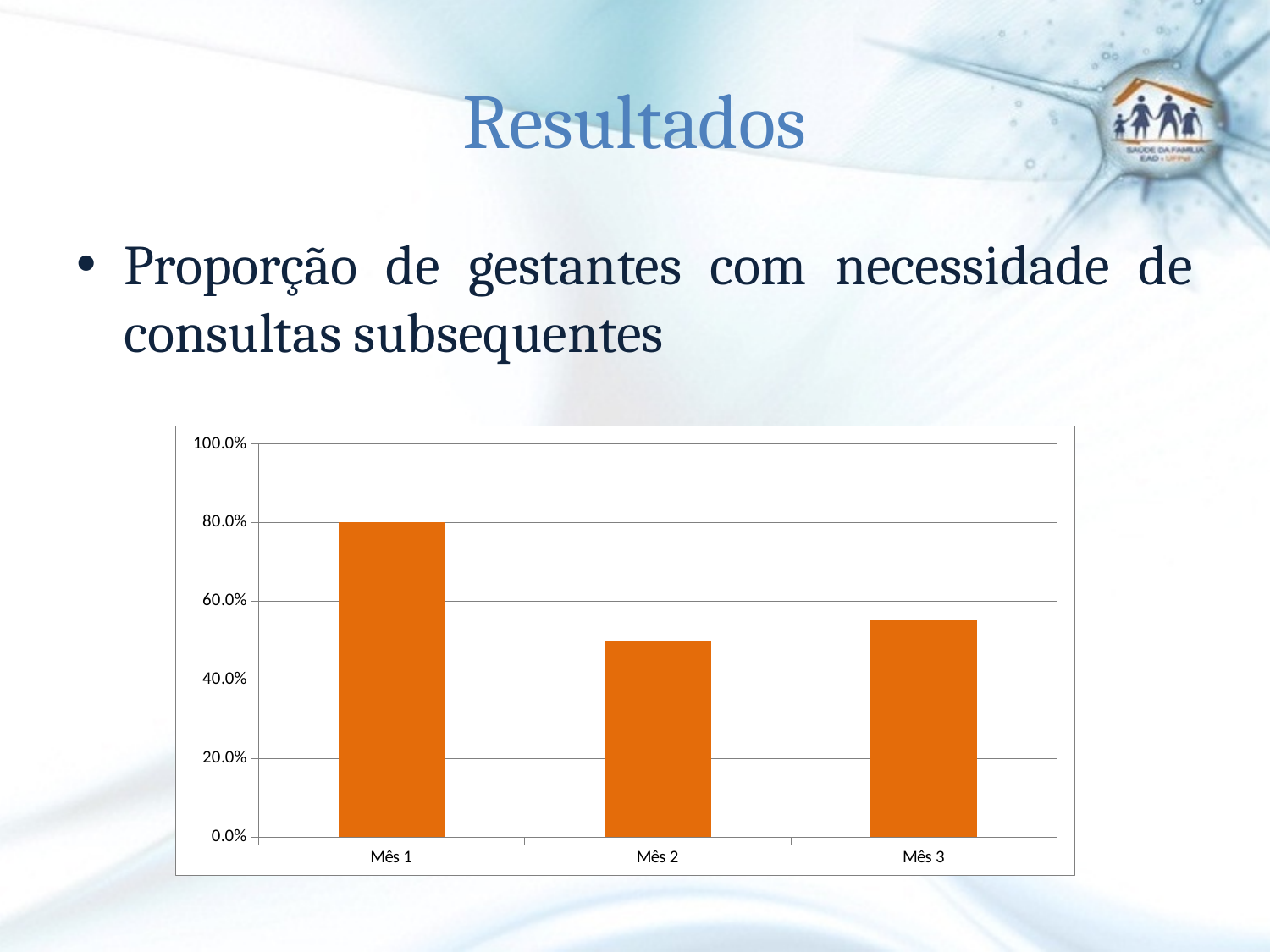
Is the value for Mês 3 greater or less than 40.0%? greater Which is larger, the value for Mês 2 or the value for Mês 3? Mês 3 Which is larger, the value for Mês 1 or the value for Mês 2? Mês 1 Is the value for Mês 2 greater or less than 60.0%? less Which month has the highest value in the chart? Mês 1 Which month has the lowest value in the chart? Mês 2 Is the value for Mês 1 greater or less than 60.0%? greater What is the value for Mês 1? 80.0% Does the value rise or fall from Mês 1 to Mês 2? fall What is the highest value shown on the chart's vertical axis? 100.0% How many categories are shown on the x axis of the chart? 3 What kind of chart is shown on the slide? bar chart